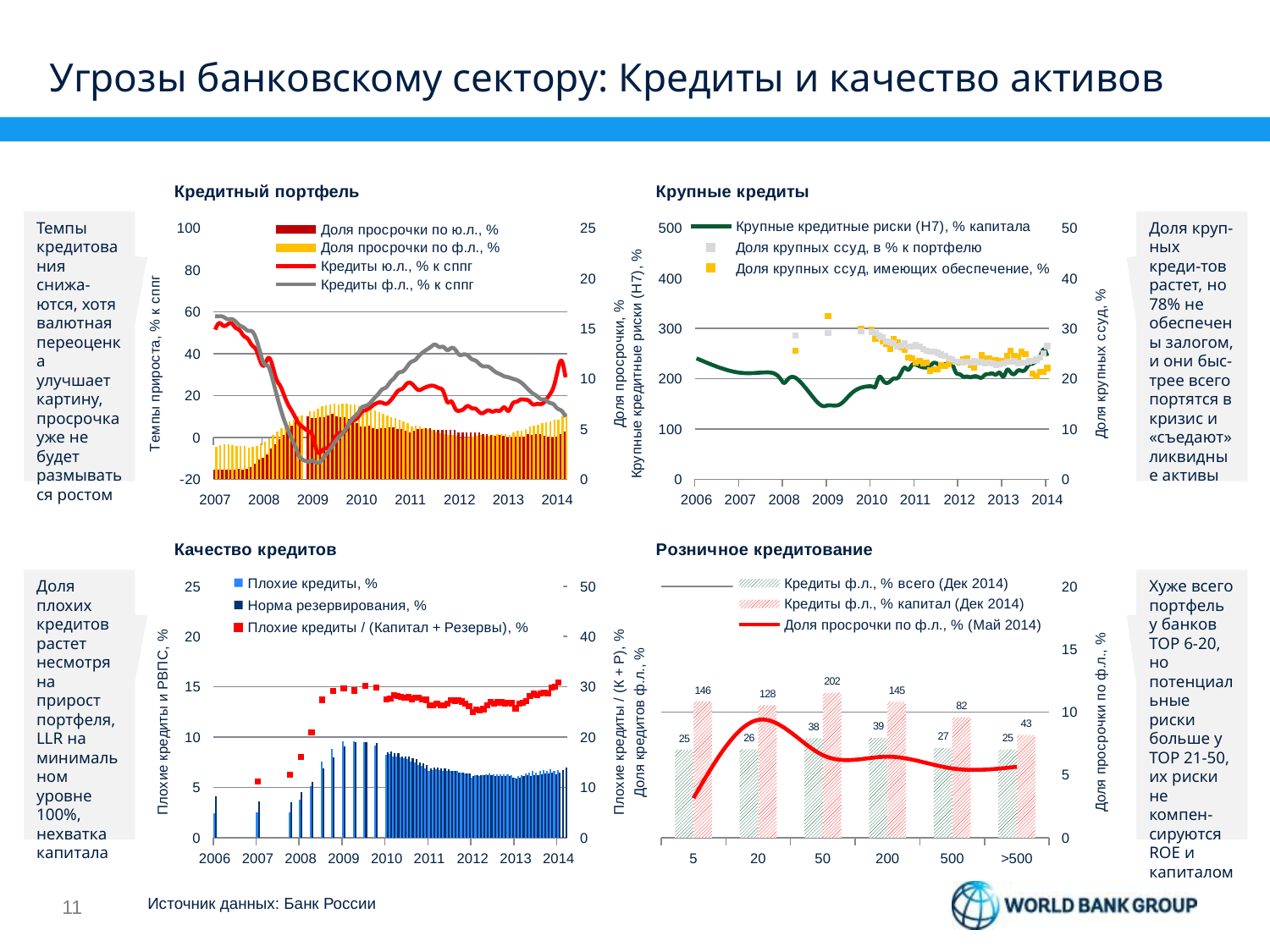
On the Розничное кредитование chart, which category has the highest value of Кредиты ф.л., % капитал (Дек 2014)? 50 What is the title of the chart in the bottom-left of the slide? Качество кредитов How many series does the legend of the Кредитный портфель chart list? 4 On the Розничное кредитование chart, what is the value of Кредиты ф.л., % всего (Дек 2014) for the 200 category? 39 On the Розничное кредитование chart, which category has the lowest value of Кредиты ф.л., % капитал (Дек 2014)? >500 On the Розничное кредитование chart, which is larger for Кредиты ф.л., % капитал (Дек 2014): the 5 category or the 500 category? 5 On the Розничное кредитование chart, what is the value of Кредиты ф.л., % капитал (Дек 2014) for the 500 category? 82 On the Розничное кредитование chart, what is the value of Кредиты ф.л., % капитал (Дек 2014) for the 50 category? 202 On the Крупные кредиты chart, does the Крупные кредитные риски (Н7), % капитала line rise or fall from 2009 to 2014? rise On the Крупные кредиты chart, is the value of Крупные кредитные риски (Н7), % капитала in 2009 greater or less than 200? less On the Розничное кредитование chart, what is the difference between the Кредиты ф.л., % капитал (Дек 2014) values for the 50 and 200 categories? 57 How many categories are shown on the x axis of the Розничное кредитование chart? 6